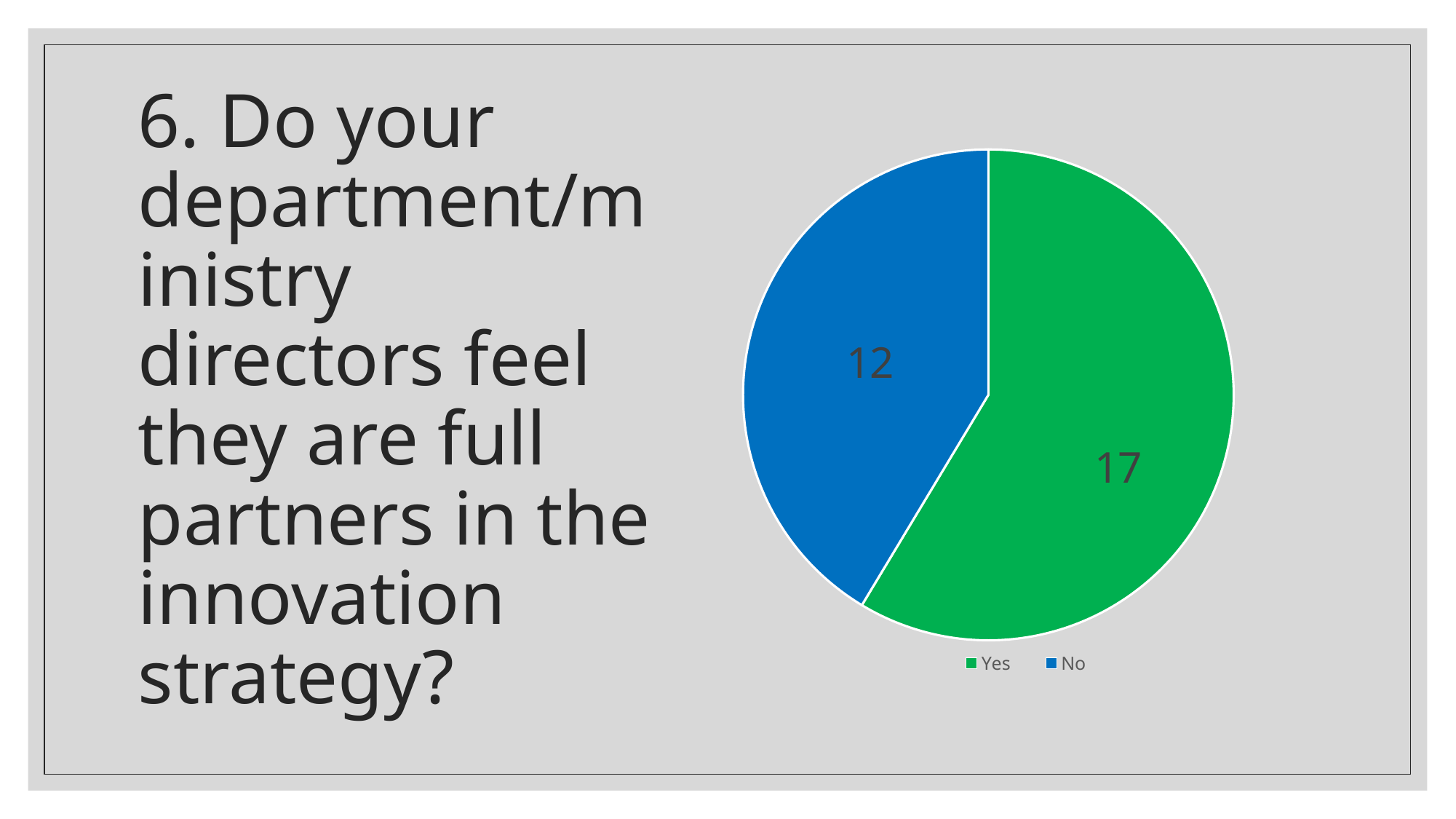
Which category has the smallest slice? No What is the value for No? 12 How many slices does the pie chart have? 2 What kind of chart is shown on the slide? pie chart What colour is the Yes slice? green What is the difference between the Yes and No values? 5 Which is larger, Yes or No? Yes What is the value for Yes? 17 What colour is the No slice? blue How many entries does the legend list? 2 What is the total of all slices in the pie chart? 29 Which category has the largest slice? Yes